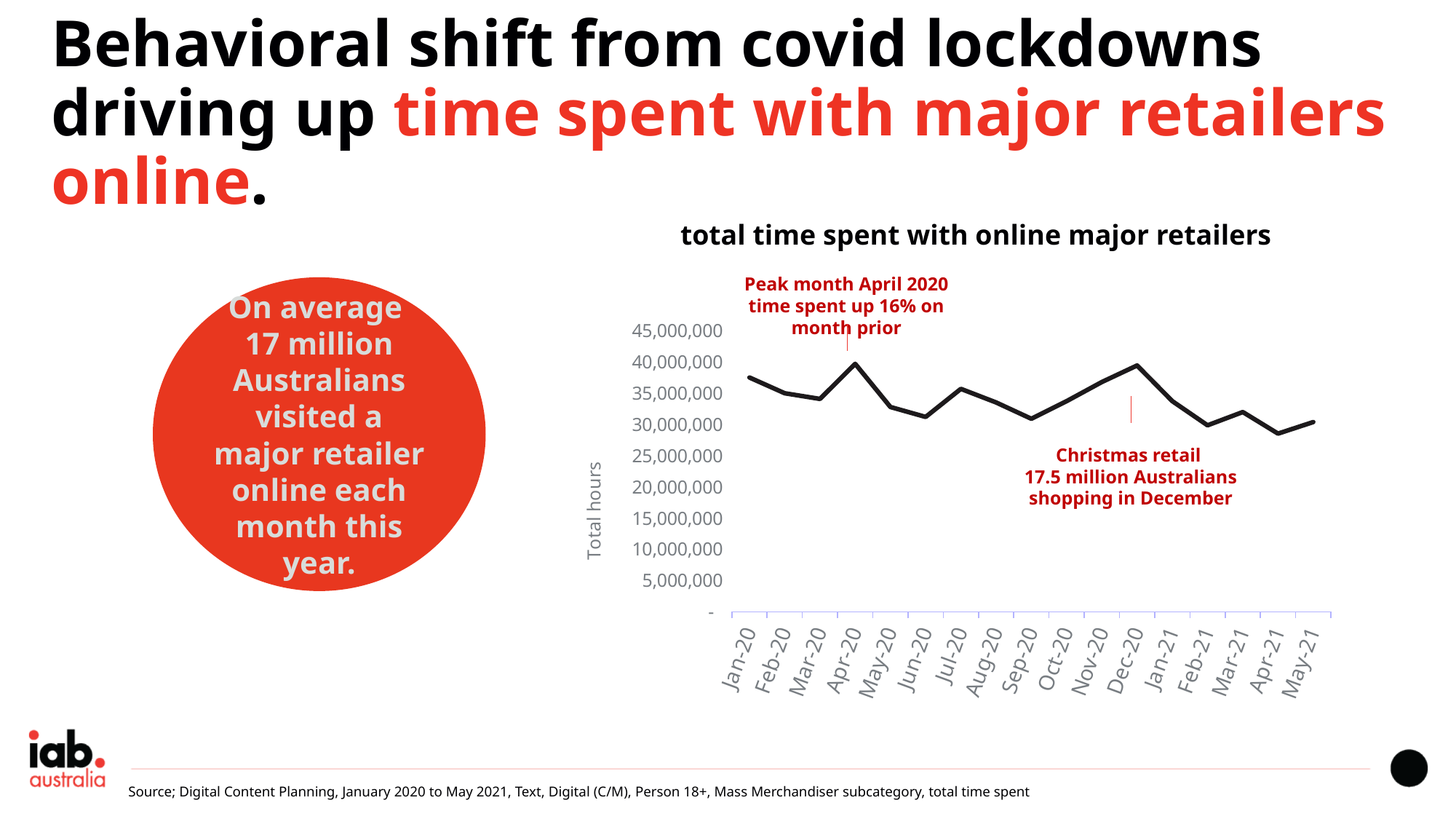
Is the value for Apr-20 greater or less than 35,000,000? greater What is the title of the chart? total time spent with online major retailers Which is larger, the value for Jan-20 or the value for Sep-20? Jan-20 Which is larger, the value for Dec-20 or the value for Feb-21? Dec-20 What is the label on the vertical axis of the chart? Total hours Is the value for Sep-20 greater or less than 35,000,000? less Is the value for Dec-20 greater or less than 35,000,000? greater Overall, do the values rise or fall from Jan-20 to May-21? fall How many months are plotted along the x axis of the chart? 17 Which is larger, the value for Apr-20 or the value for May-20? Apr-20 What kind of chart is shown on the slide? line chart